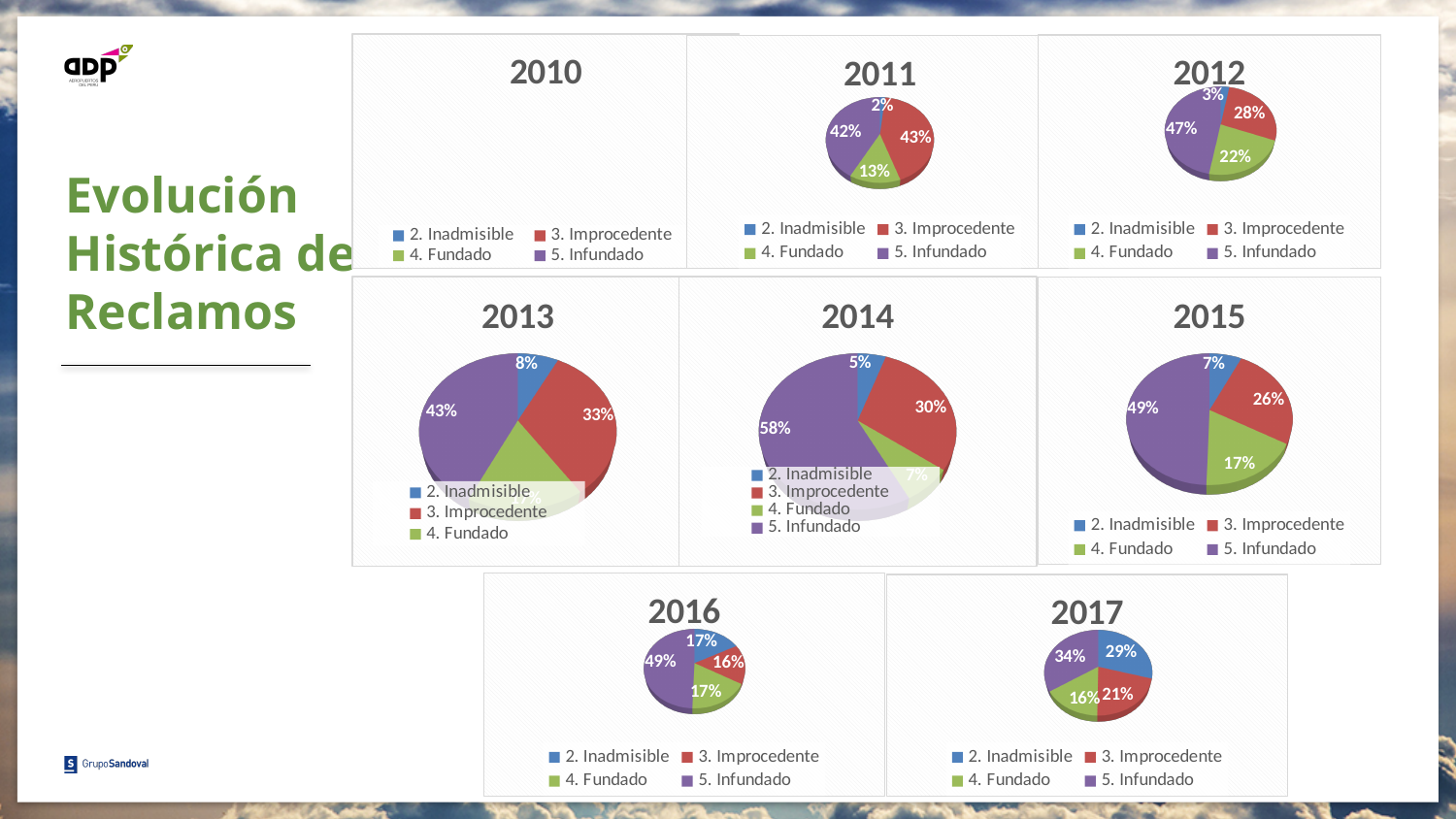
In the 2017 pie chart, which is larger: the share of 2. Inadmisible or the share of 3. Improcedente? 2. Inadmisible In the 2012 pie chart, what is the difference between the shares of 5. Infundado and 3. Improcedente? 19% Which year's chart panel shows no pie chart data? 2010 How many categories does the legend of the 2016 pie chart list? 4 What type of chart is used for the 2013 data? Pie chart In the 2011 pie chart, which category has the smallest share? 2. Inadmisible In the 2014 pie chart, which category has the largest share? 5. Infundado In the 2011 pie chart, what percentage is shown for 3. Improcedente? 43% In the 2012 pie chart, what percentage is shown for 5. Infundado? 47% In the 2015 pie chart, what percentage is shown for 4. Fundado? 17% In the 2017 pie chart, what percentage is shown for 2. Inadmisible? 29% In the 2015 pie chart, what is the difference between the shares of 5. Infundado and 2. Inadmisible? 42%